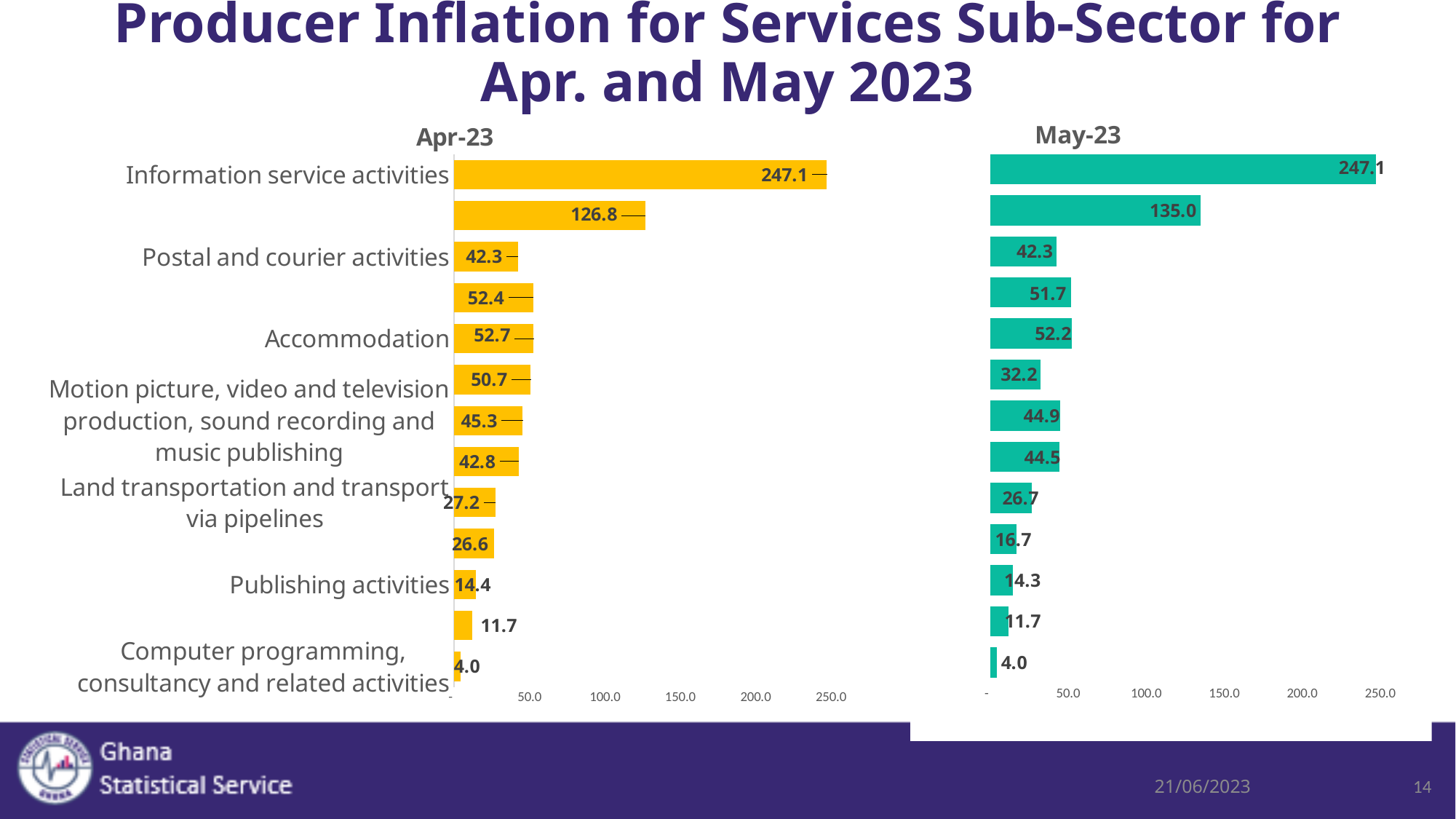
What is the difference between the Apr-23 and May-23 values for Land transportation and transport via pipelines? 0.5 In the May-23 chart, what is the value for Publishing activities? 14.3 In the Apr-23 chart, what is the value for Information service activities? 247.1 In the Apr-23 chart, which category has the highest value? Information service activities Is the Apr-23 value for Accommodation larger or smaller than the May-23 value for Accommodation? larger In the May-23 chart, is the value for Information service activities greater or less than 200.0? greater In the Apr-23 chart, what is the value for Accommodation? 52.7 In the May-23 chart, which category has the lowest value? Computer programming, consultancy and related activities How many bars are plotted in the Apr-23 chart? 13 In the May-23 chart, what is the value for Postal and courier activities? 42.3 What colour are the bars in the Apr-23 chart? Yellow What type of chart is used for the May-23 data? Bar chart